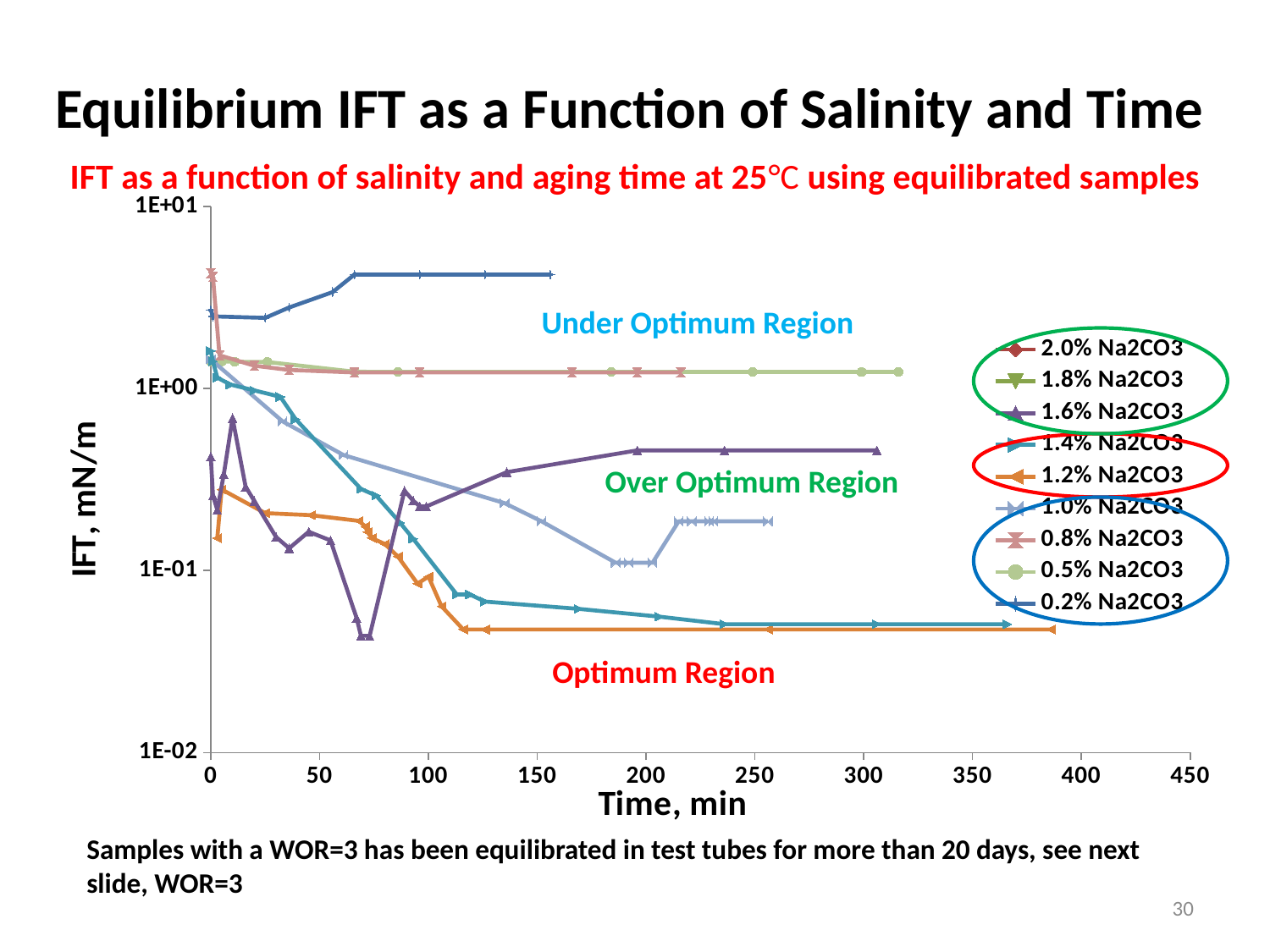
Is the value for 0.2% Na2CO3 at 150 min greater or less than 1E+00? greater Is the value for 0.8% Na2CO3 at 200 min greater or less than 1E+00? greater Is the value for 1.6% Na2CO3 at 300 min greater or less than 1E+00? less How many series does the chart legend list? 9 What is the label of the x axis of the chart? Time, min What is the title of the chart? IFT as a function of salinity and aging time at 25℃ using equilibrated samples At 300 min, which series has the larger value, 0.8% Na2CO3 or 1.2% Na2CO3? 0.8% Na2CO3 Does the 0.2% Na2CO3 series rise or fall as time increases? rise Does the 1.2% Na2CO3 series rise or fall as time increases? fall What kind of chart is shown on the slide? line chart